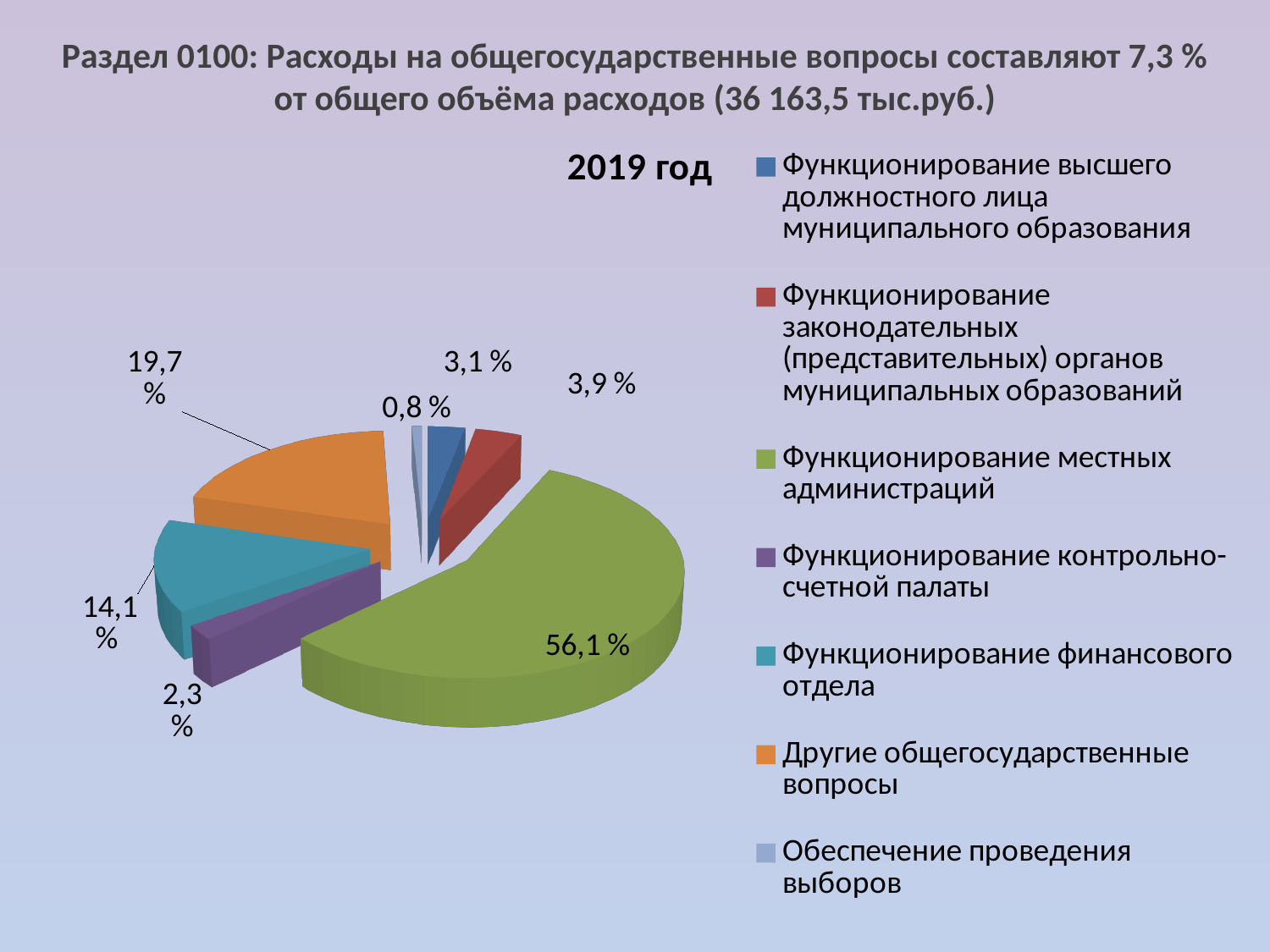
How many categories does the legend of the pie chart list? 7 What share of the pie does "Функционирование местных администраций" have? 56,1 % What is the title of the chart? 2019 год What kind of chart is shown on the slide? pie chart What share of the pie does "Обеспечение проведения выборов" have? 0,8 % Which category has the largest slice of the pie? Функционирование местных администраций What share of the pie does "Функционирование контрольно-счетной палаты" have? 2,3 % What share of the pie does "Функционирование финансового отдела" have? 14,1 % What share of the pie does "Другие общегосударственные вопросы" have? 19,7 % What is the difference between the shares of "Функционирование местных администраций" and "Другие общегосударственные вопросы"? 36,4 % Which is larger: the share of "Функционирование законодательных (представительных) органов муниципальных образований" or the share of "Функционирование высшего должностного лица муниципального образования"? Функционирование законодательных (представительных) органов муниципальных образований Which category has the smallest slice of the pie? Обеспечение проведения выборов